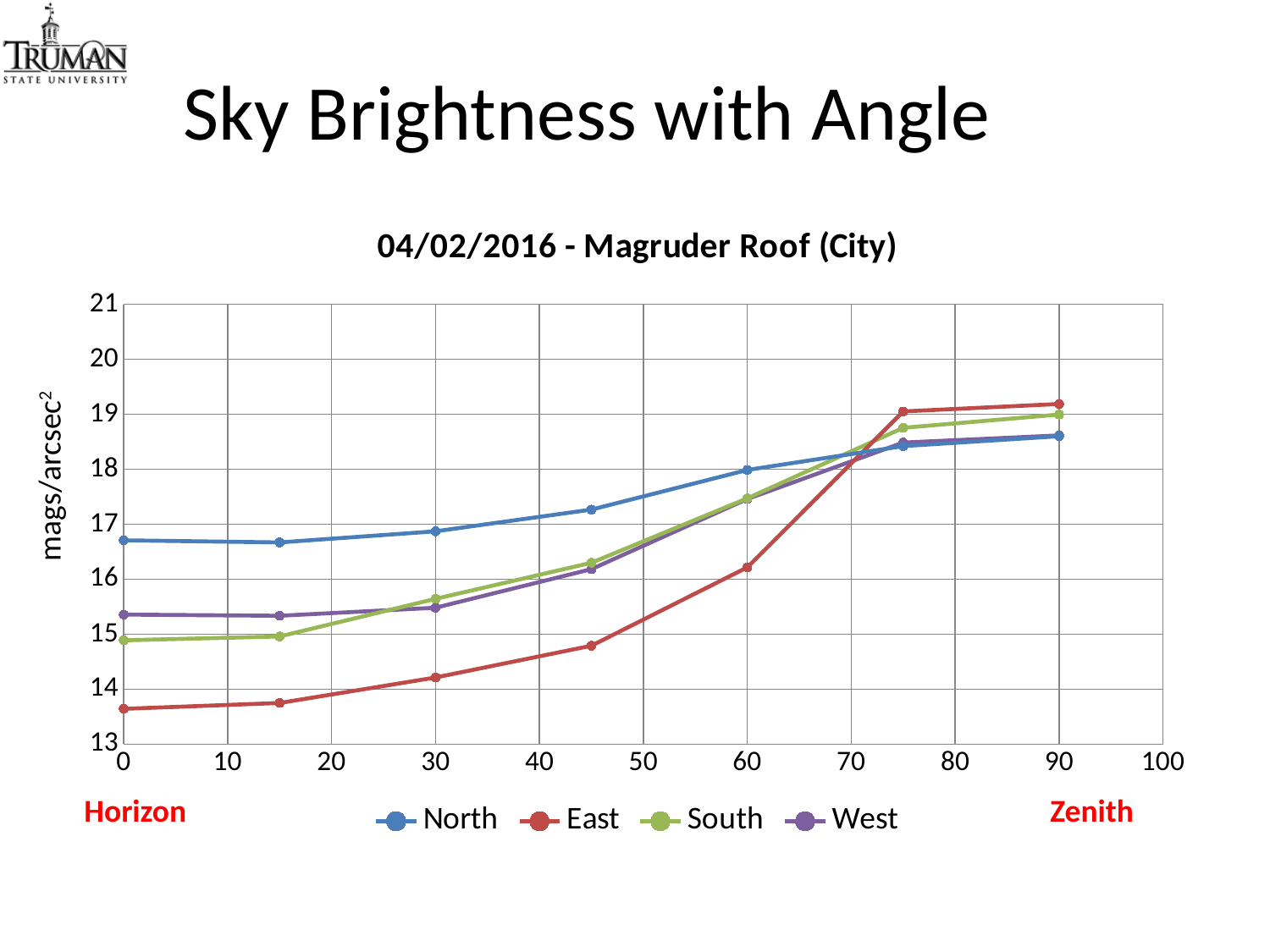
How many series does the legend list? 4 Which series has the highest value at an angle of 90? East Is the value for East at an angle of 0 greater or less than 14? less Is the value for North at an angle of 90 greater or less than 18? greater What kind of chart is shown on the slide? line chart Do the East values rise or fall as the angle increases from 0 to 90? rise What is the title of the chart? 04/02/2016 - Magruder Roof (City) At an angle of 30, which is larger, the North value or the East value? North Which series has the lowest value at an angle of 0? East How many data points does the North series have? 7 Is the value for East at an angle of 45 greater or less than 15? less Which series has the highest value at an angle of 0? North